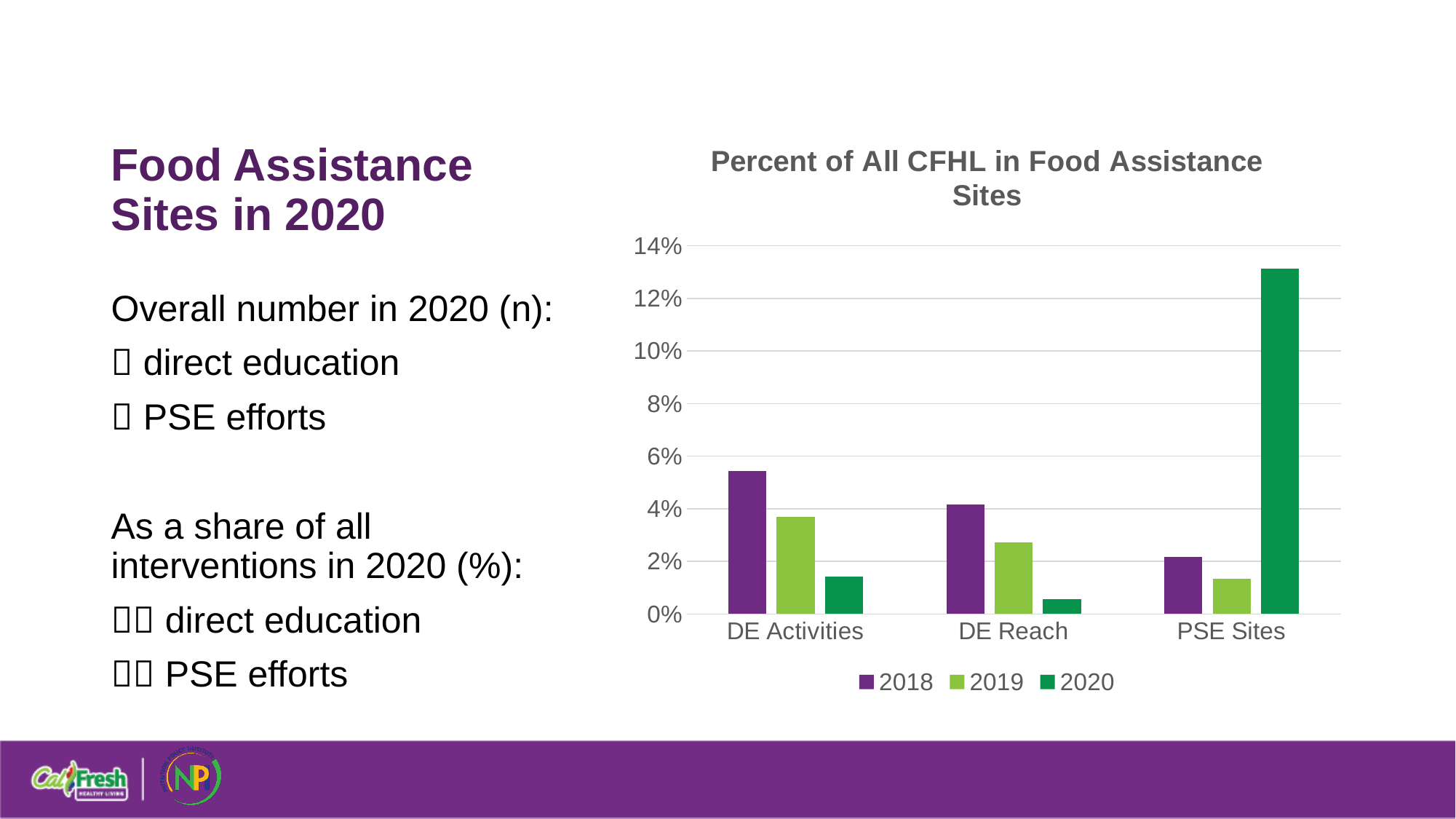
Which category has the tallest bar in the chart? PSE Sites Which series has the tallest bar for PSE Sites? 2020 For DE Activities, do the values rise or fall from 2018 to 2020? fall How many series does the chart's legend list? 3 What kind of chart is shown on the slide? bar chart Which series has the lowest bar for DE Reach? 2020 Is the 2020 value for PSE Sites greater or less than 12%? greater What is the title of the chart? Percent of All CFHL in Food Assistance Sites Which is larger for DE Activities: the 2018 value or the 2019 value? 2018 Is the 2018 value for DE Activities greater or less than 6%? less Is the 2020 value for DE Reach greater or less than 2%? less How many categories are shown on the x axis of the chart? 3